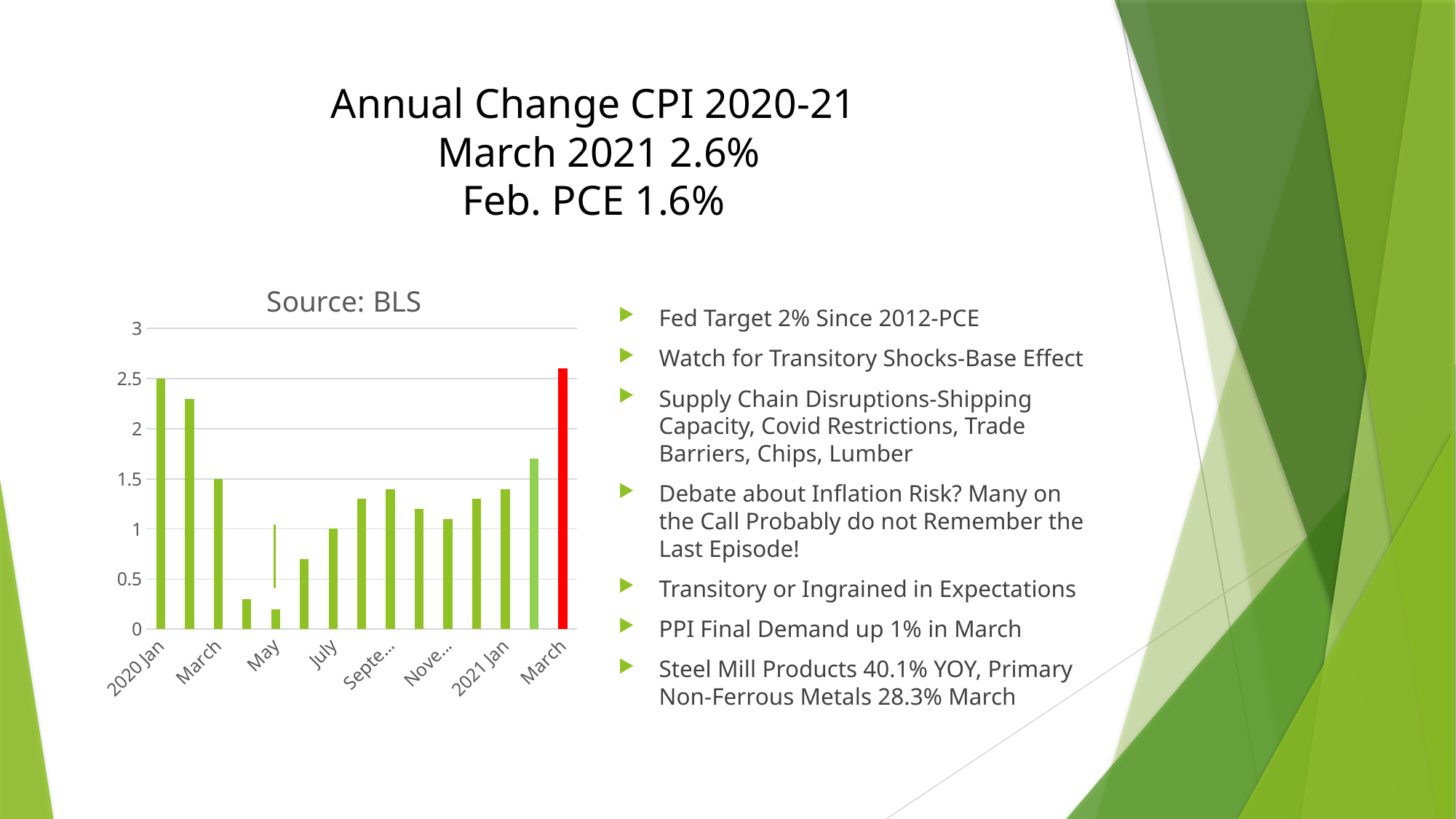
What kind of chart is shown on the slide? bar chart What is the annual CPI change for March 2021, as stated on the slide? 2.6% How many bars are plotted in the chart? 15 Is the value for July (2020) greater or less than 1.5? less Which month has the highest bar in the chart? March (2021) Do the values rise or fall from 2020 Jan to May 2020? fall Is the value for May (2020) greater or less than 0.5? less What is the title shown above the chart? Source: BLS Is the value for 2020 Jan greater or less than 2? greater What colour is the bar for March 2021, which differs from the other bars? red Which is larger, the value for 2020 Jan or the value for 2021 Jan? 2020 Jan